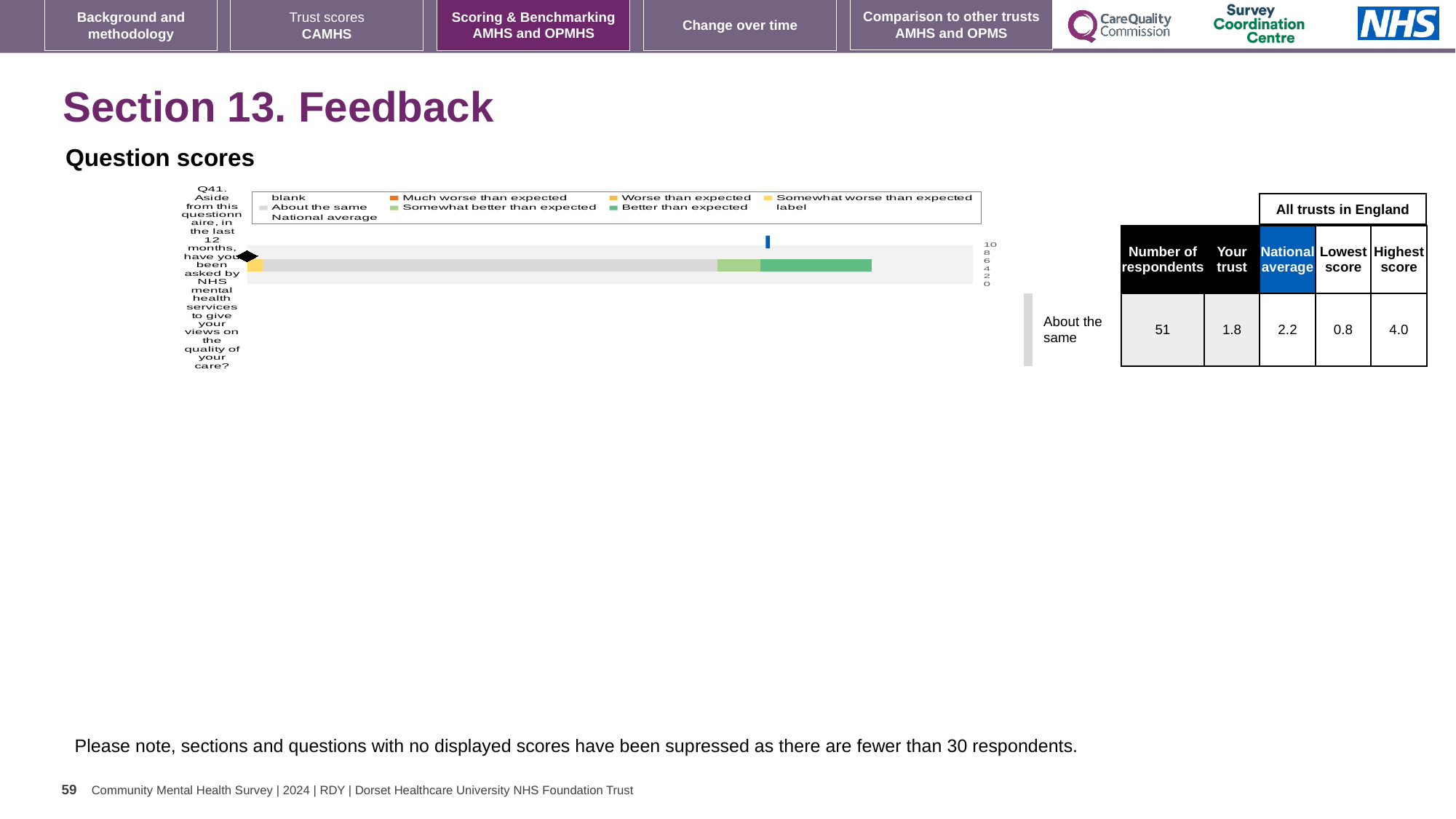
What is the national average score for Q41? 2.2 What is the 'Your trust' score for Q41? 1.8 What is the difference between the highest score (4.0) and the lowest score (0.8) for Q41? 3.2 Which question number is plotted in the Question scores chart? Q41 How many respondents answered Q41? 51 How many questions are plotted in the Question scores chart? 1 Which is larger for Q41, the 'Your trust' score or the national average? national average What kind of chart is shown under 'Question scores'? bar chart In the chart legend, what colour represents 'About the same'? grey In the chart legend, what colour represents 'Better than expected'? green What is the highest score among all trusts in England for Q41? 4.0 Is the 'Your trust' marker for Q41 on the chart greater or less than 4? less